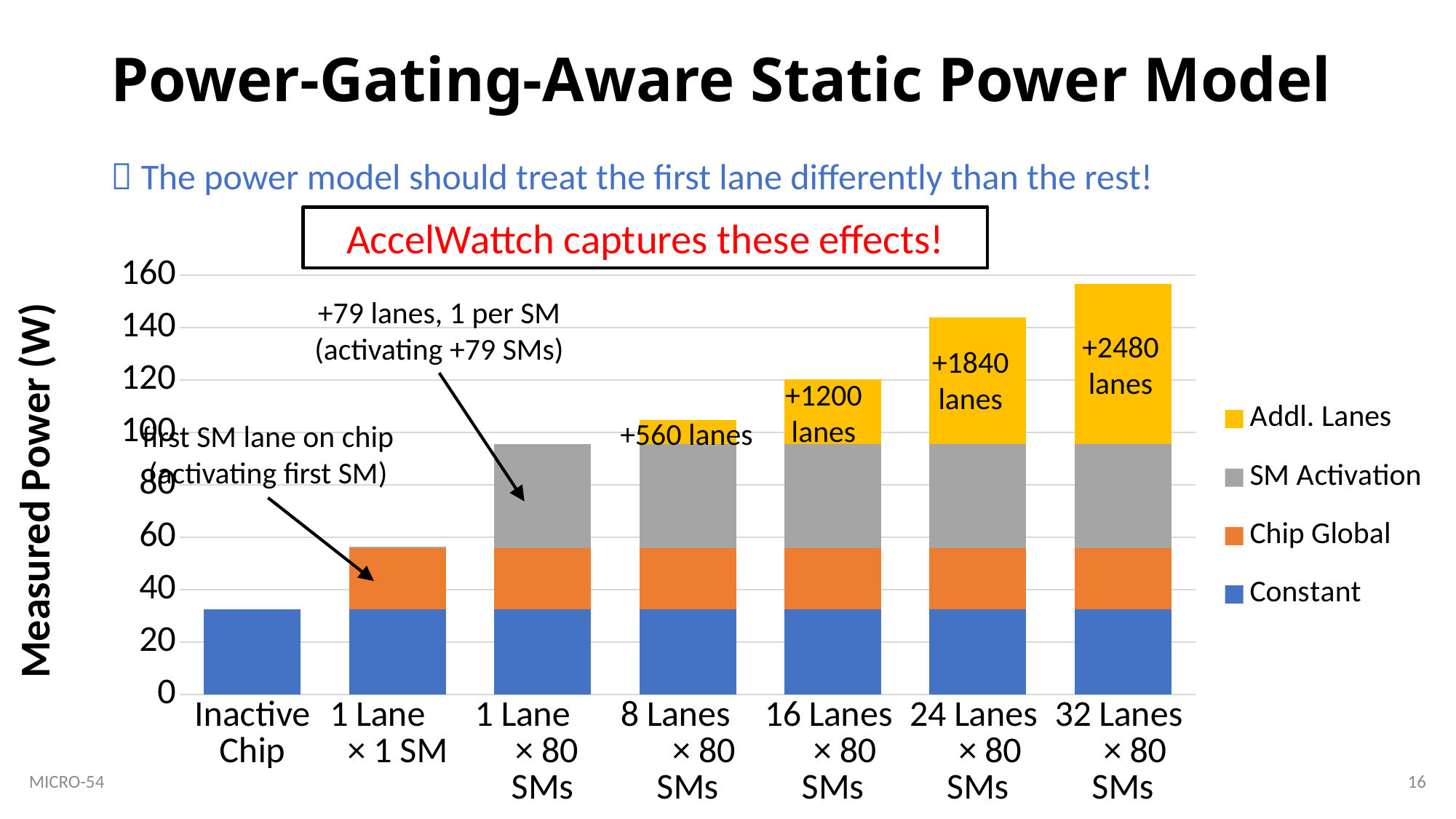
Is the total value for 16 Lanes × 80 SMs greater or less than 100? greater What is the title of the chart's y axis? Measured Power (W) Which category has the lowest total measured power? Inactive Chip How many categories are shown along the x axis of the chart? 7 Which has a larger total measured power: 24 Lanes × 80 SMs or 8 Lanes × 80 SMs? 24 Lanes × 80 SMs How many series does the chart's legend list? 4 Which category has the highest total measured power? 32 Lanes × 80 SMs Do the total bar heights rise or fall moving from left to right along the x axis? rise What kind of chart is shown on the slide? Stacked bar chart Is the total value for 32 Lanes × 80 SMs greater or less than 140? greater Is the total value for Inactive Chip greater or less than 40? less Which series is shown at the bottom of each stacked bar? Constant